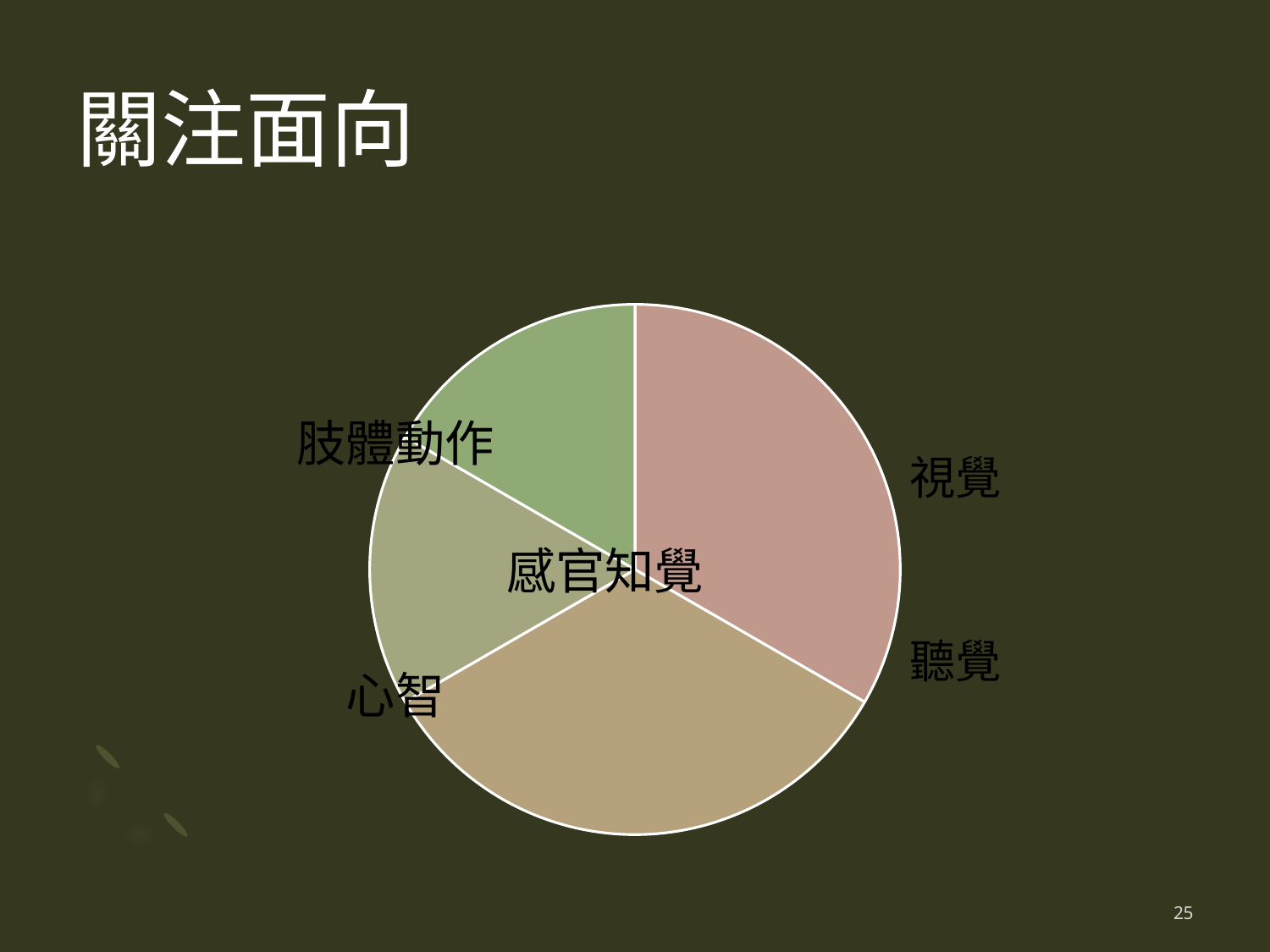
Which slice is larger, 視覺 or 心智? 視覺 What is the title of the slide containing the pie chart? 關注面向 How many slices does the pie chart have? 4 Which slice is smaller, 心智 or 聽覺? 心智 Which slice is larger, 視覺 or 肢體動作? 視覺 What kind of chart is shown on the slide? pie chart What colour is the 視覺 slice of the pie chart? pink